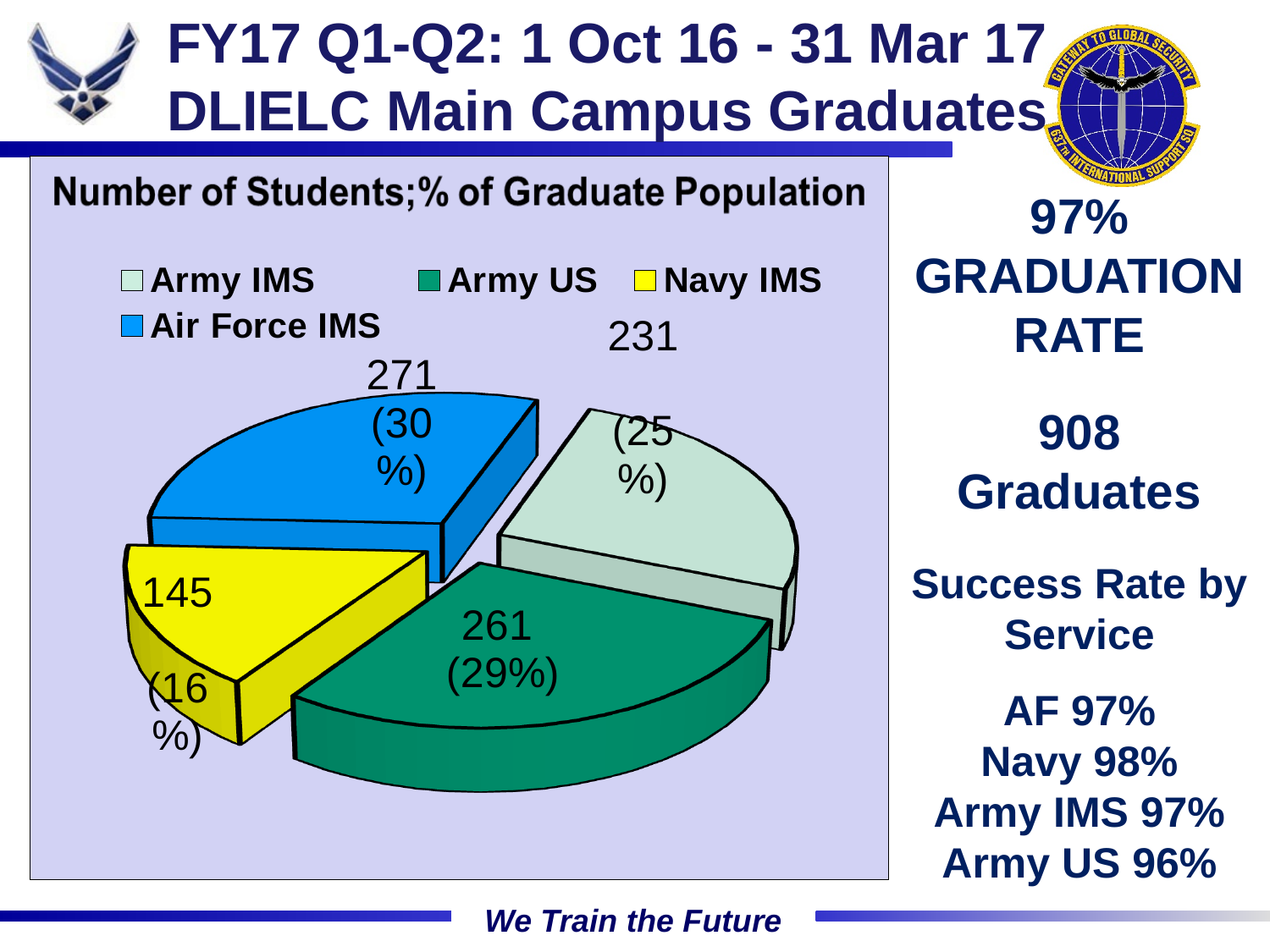
What is the number of students for Navy IMS? 145 What is the number of students for Army IMS? 231 What is the difference in number of students between Air Force IMS and Navy IMS? 126 Which category has the smallest number of students? Navy IMS What is the number of students for Air Force IMS? 271 What share of the graduate population does Navy IMS represent? 16% What is the number of students for Army US? 261 What share of the graduate population does Army US represent? 29% What is the title of the chart? Number of Students;% of Graduate Population How many categories does the pie chart show? 4 Which category has the largest number of students? Air Force IMS What kind of chart is shown on the slide? Pie chart